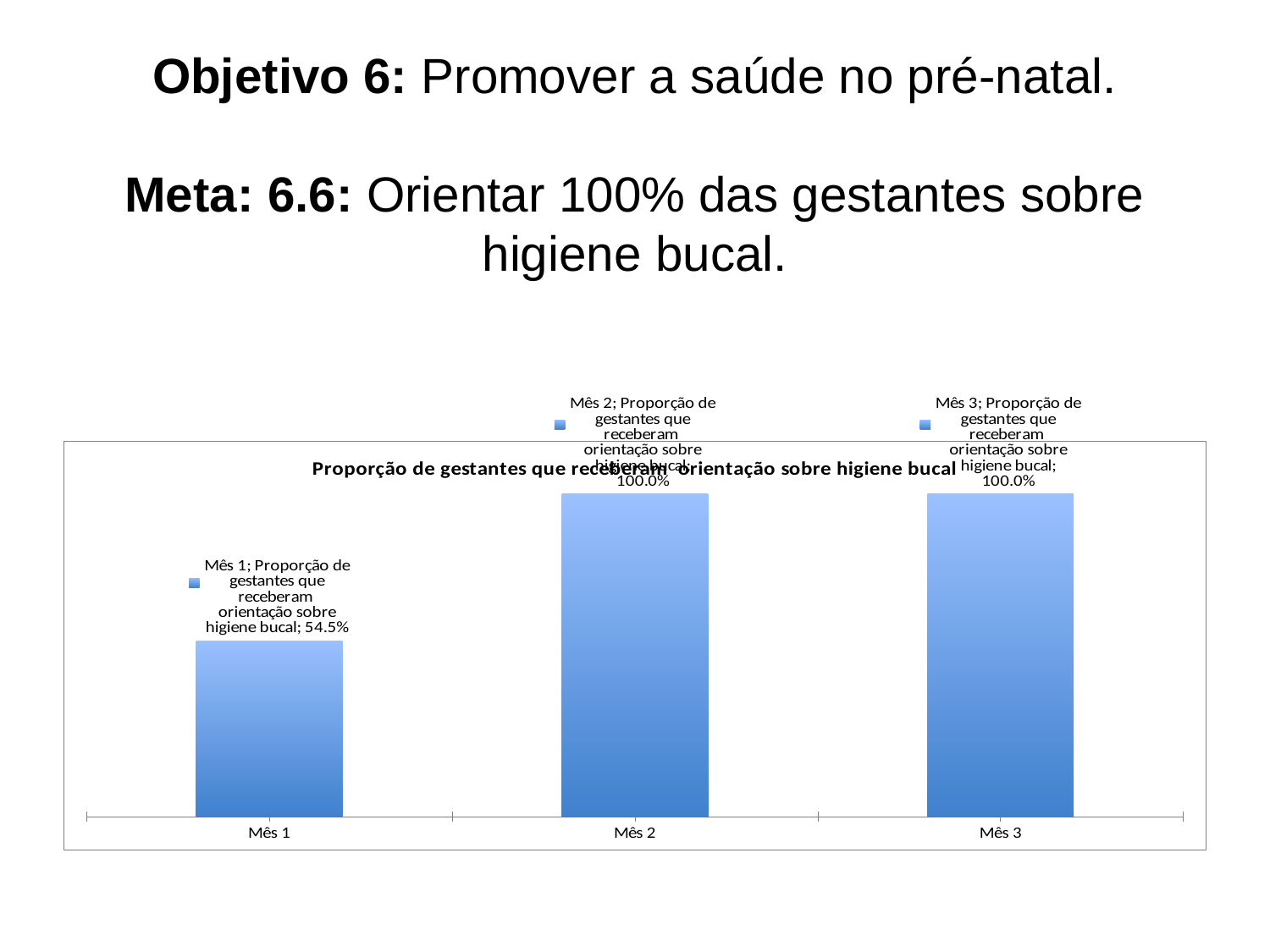
What is the value for Mês 2? 100.0% Do the values rise or fall from Mês 1 to Mês 2? Rise What is the value for Mês 1? 54.5% Which month has the lowest value? Mês 1 Which is larger, the value for Mês 1 or the value for Mês 3? Mês 3 Do Mês 2 and Mês 3 have the same value? Yes What is the difference between the values for Mês 2 and Mês 1? 45.5% How many months are shown on the x axis? 3 What is the title of the chart? Proporção de gestantes que receberam orientação sobre higiene bucal What is the value for Mês 3? 100.0% What kind of chart is shown on the slide? Bar chart